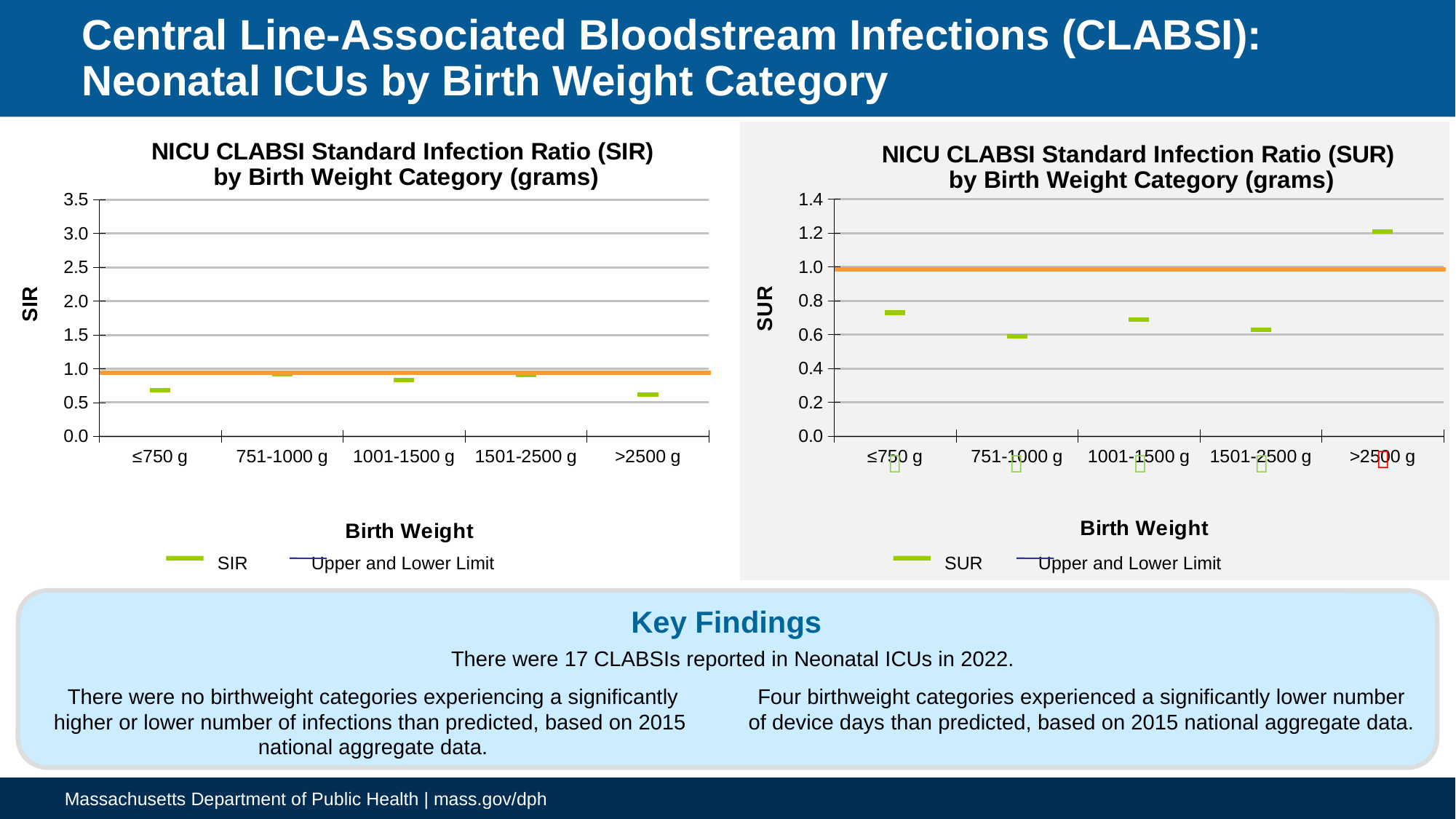
In the NICU CLABSI SIR chart on the left, which is larger, the SIR for 751-1000 g or the SIR for >2500 g? 751-1000 g In the NICU CLABSI SUR chart on the right, what is the second legend entry? Upper and Lower Limit In the NICU CLABSI SUR chart on the right, which is larger, the SUR for >2500 g or the SUR for ≤750 g? >2500 g In the NICU CLABSI SIR chart on the left, is the SIR for ≤750 g greater or less than 1.0? less In the NICU CLABSI SUR chart on the right, is the SUR for ≤750 g greater or less than 0.6? greater In the NICU CLABSI SIR chart on the left, how many birth weight categories are shown on the x axis? 5 In the NICU CLABSI SUR chart on the right, which birth weight category has the highest SUR? >2500 g In the NICU CLABSI SUR chart on the right, how many series does the legend list? 2 In the NICU CLABSI SIR chart on the left, is the SIR for >2500 g greater or less than 1.0? less In the NICU CLABSI SUR chart on the right, which is larger, the SUR for ≤750 g or the SUR for 751-1000 g? ≤750 g What is the y-axis label of the chart on the left? SIR